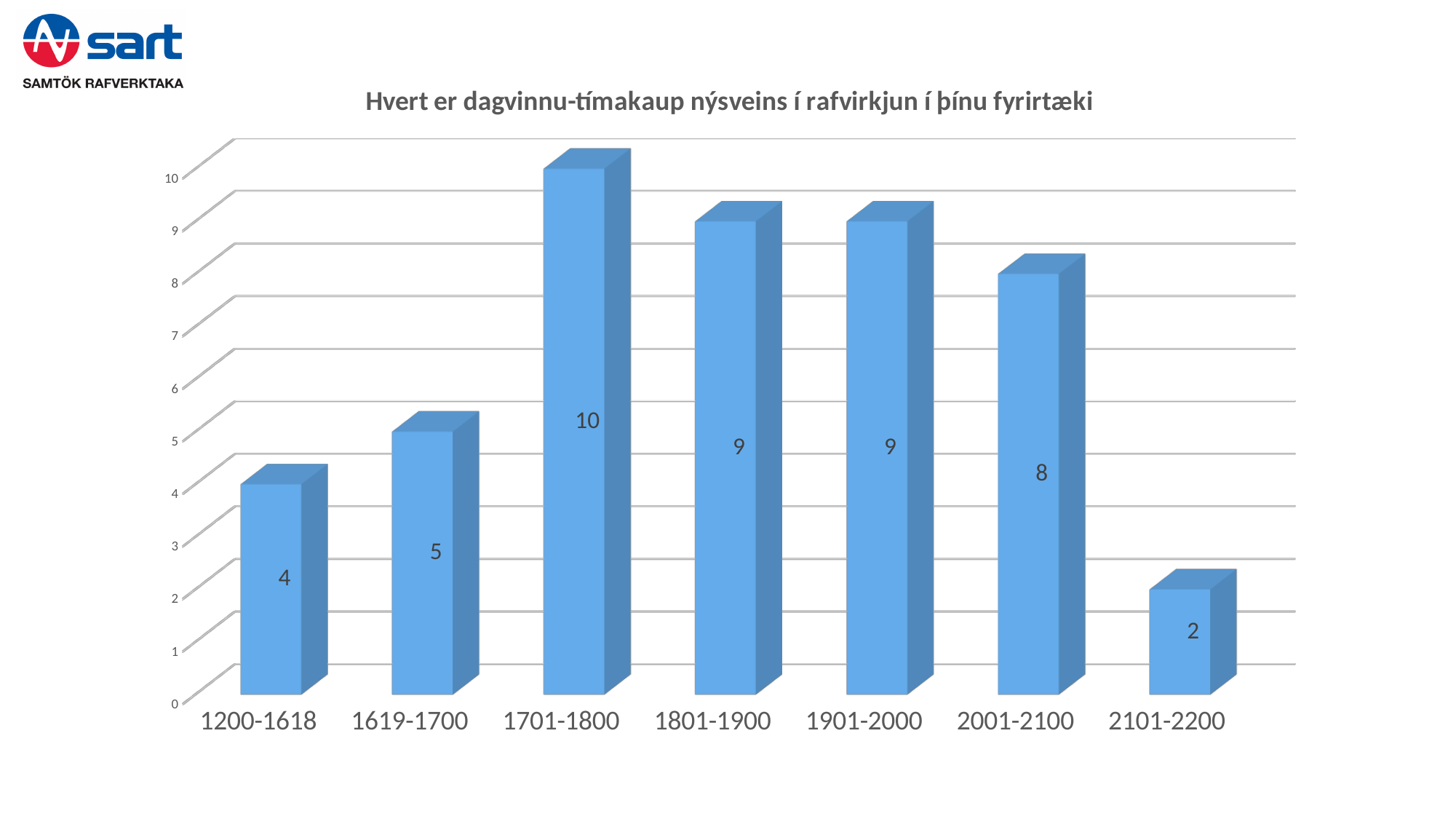
Which is larger, the value for 1619-1700 or the value for 2001-2100? 2001-2100 What is the value for the 1701-1800 category? 10 What is the difference between the values for 1701-1800 and 2101-2200? 8 What is the total of the values for 1801-1900 and 1901-2000? 18 What kind of chart is shown on the slide? Bar chart What is the title of the chart? Hvert er dagvinnu-tímakaup nýsveins í rafvirkjun í þínu fyrirtæki What is the value for the 2001-2100 category? 8 Which category has the highest value? 1701-1800 How many categories are shown on the x axis? 7 Which category has the lowest value? 2101-2200 What is the value for the 1200-1618 category? 4 What is the value for the 2101-2200 category? 2